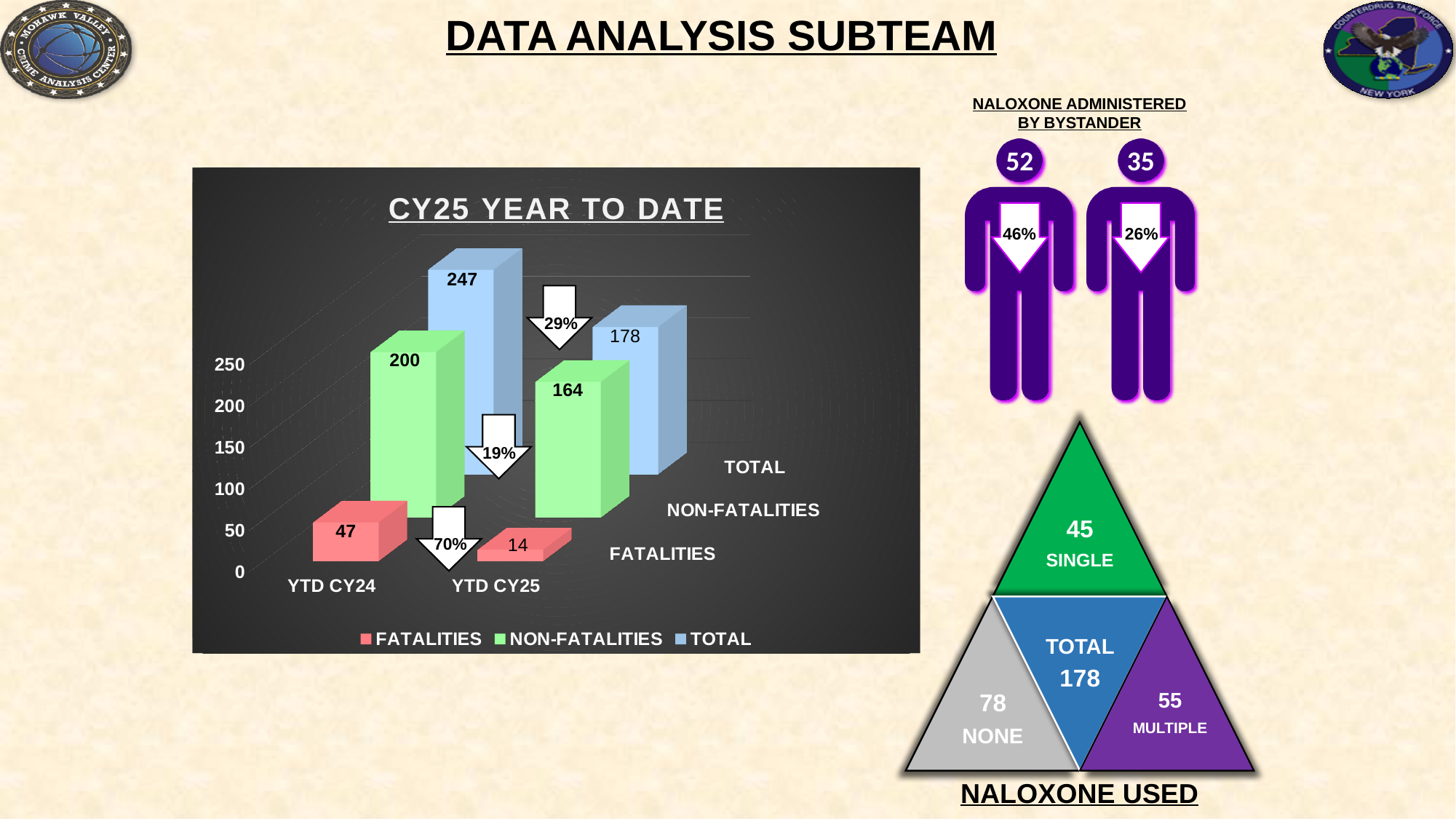
In the CY25 YEAR TO DATE chart, what is the TOTAL value for YTD CY24? 247 In the CY25 YEAR TO DATE chart, what is the difference between the TOTAL values for YTD CY24 and YTD CY25? 69 In the CY25 YEAR TO DATE chart, what is the value for FATALITIES in YTD CY24? 47 In the CY25 YEAR TO DATE chart, what is the value for NON-FATALITIES in YTD CY25? 164 What kind of chart is the CY25 YEAR TO DATE chart? Bar chart In the CY25 YEAR TO DATE chart, what is the TOTAL value for YTD CY25? 178 In the CY25 YEAR TO DATE chart, is the NON-FATALITIES value larger in YTD CY24 or YTD CY25? YTD CY24 How many series does the legend of the CY25 YEAR TO DATE chart list? 3 In the CY25 YEAR TO DATE chart, what percentage decrease is shown next to the TOTAL bars? 29% In the CY25 YEAR TO DATE chart, which series has the highest value in YTD CY24? TOTAL In the CY25 YEAR TO DATE chart, what is the difference between FATALITIES in YTD CY24 and YTD CY25? 33 In the CY25 YEAR TO DATE chart, which series has the lowest value in YTD CY25? FATALITIES